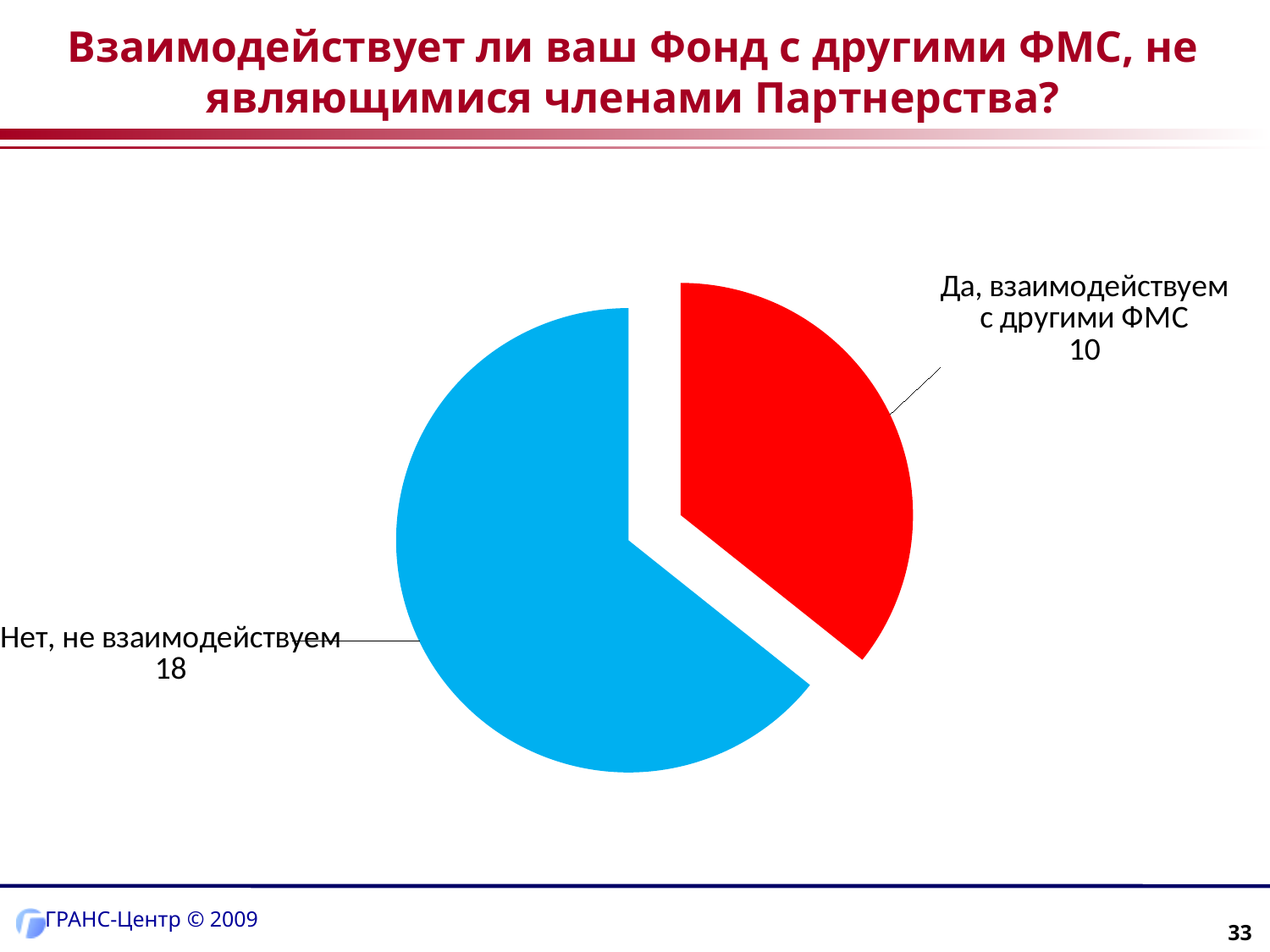
What colour is the slice for "Да, взаимодействуем с другими ФМС"? red What kind of chart is shown on the slide? pie chart How many slices does the pie chart have? 2 What is the total of all slices in the pie chart? 28 Which is larger: the value for "Да, взаимодействуем с другими ФМС" or for "Нет, не взаимодействуем"? Нет, не взаимодействуем Which category has the smallest slice of the pie? Да, взаимодействуем с другими ФМС What is the value for "Нет, не взаимодействуем"? 18 What is the difference between the values for "Нет, не взаимодействуем" and "Да, взаимодействуем с другими ФМС"? 8 What is the value for "Да, взаимодействуем с другими ФМС"? 10 Which category has the largest slice of the pie? Нет, не взаимодействуем What is the title of the slide containing the chart? Взаимодействует ли ваш Фонд с другими ФМС, не являющимися членами Партнерства? What share of the pie does "Нет, не взаимодействуем" represent? 18 of 28 (64.3%)